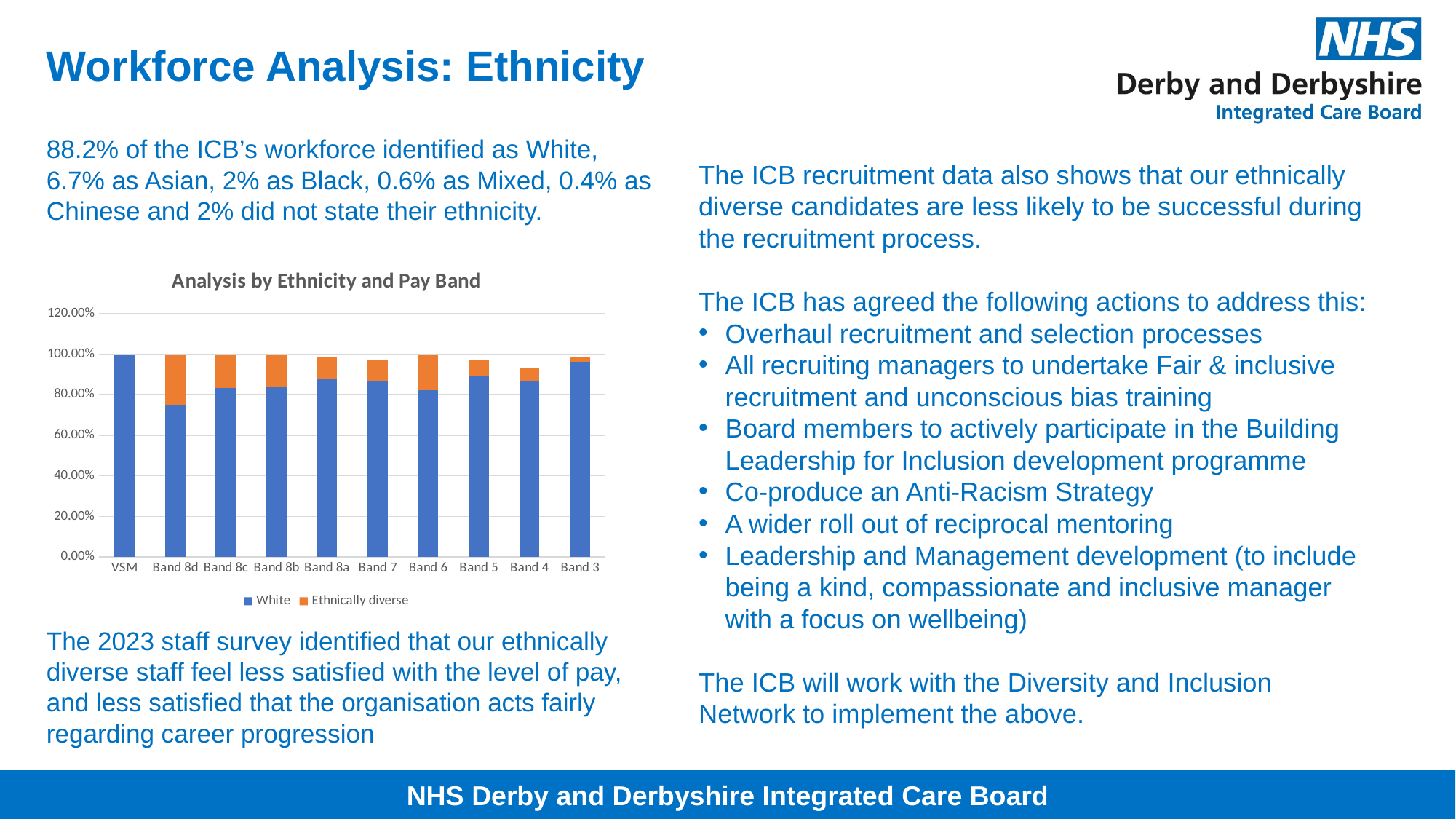
Which pay band has the highest White share? VSM Is the total height of the stacked bar for Band 4 greater or less than 100.00%? less Which pay band has the lowest White share? Band 8d How many pay band categories are shown on the x axis of the chart? 10 Is the White value for Band 3 greater or less than 80.00%? greater How many series does the chart legend list? 2 Is the White value for Band 8d greater or less than 80.00%? less What is the title of the chart? Analysis by Ethnicity and Pay Band Which has the larger White share, Band 8d or Band 3? Band 3 What are the two series named in the chart legend? White and Ethnically diverse Which pay band has the largest Ethnically diverse share? Band 8d What kind of chart is shown on the slide? Bar chart